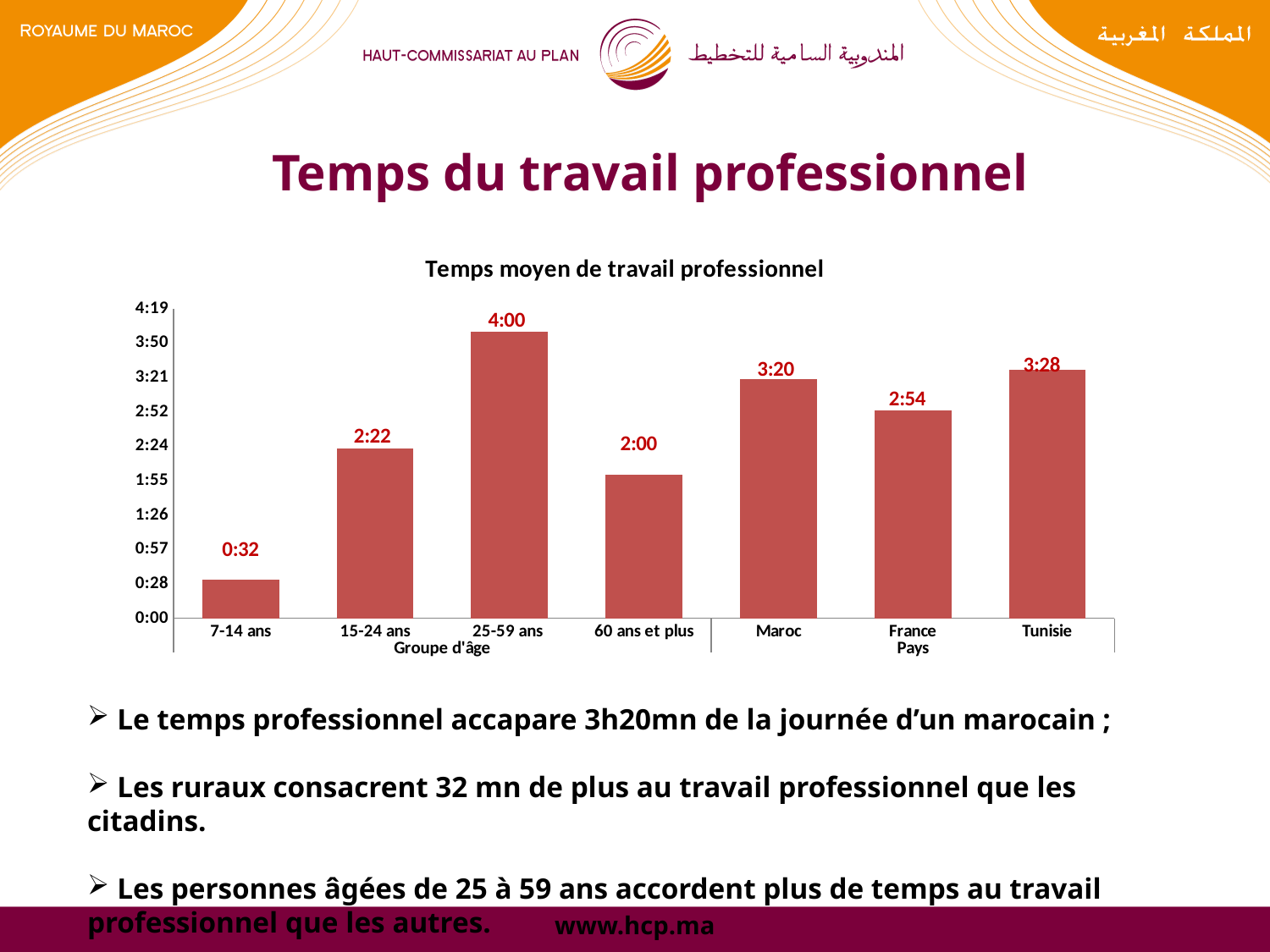
Which is larger, the value for Maroc or the value for France? Maroc What is the average professional work time shown for the 25-59 ans group? 4:00 What is the difference between the values for 25-59 ans and 15-24 ans? 1:38 Which category has the lowest average professional work time? 7-14 ans How many categories are plotted in the chart? 7 What value is shown for France? 2:54 What type of chart is shown on the slide? Bar chart Which category has the highest average professional work time? 25-59 ans What value is shown for Maroc in the chart? 3:20 What is the title of the chart? Temps moyen de travail professionnel What is the difference between the values for Tunisie and France? 0:34 What value is shown for the 7-14 ans group? 0:32